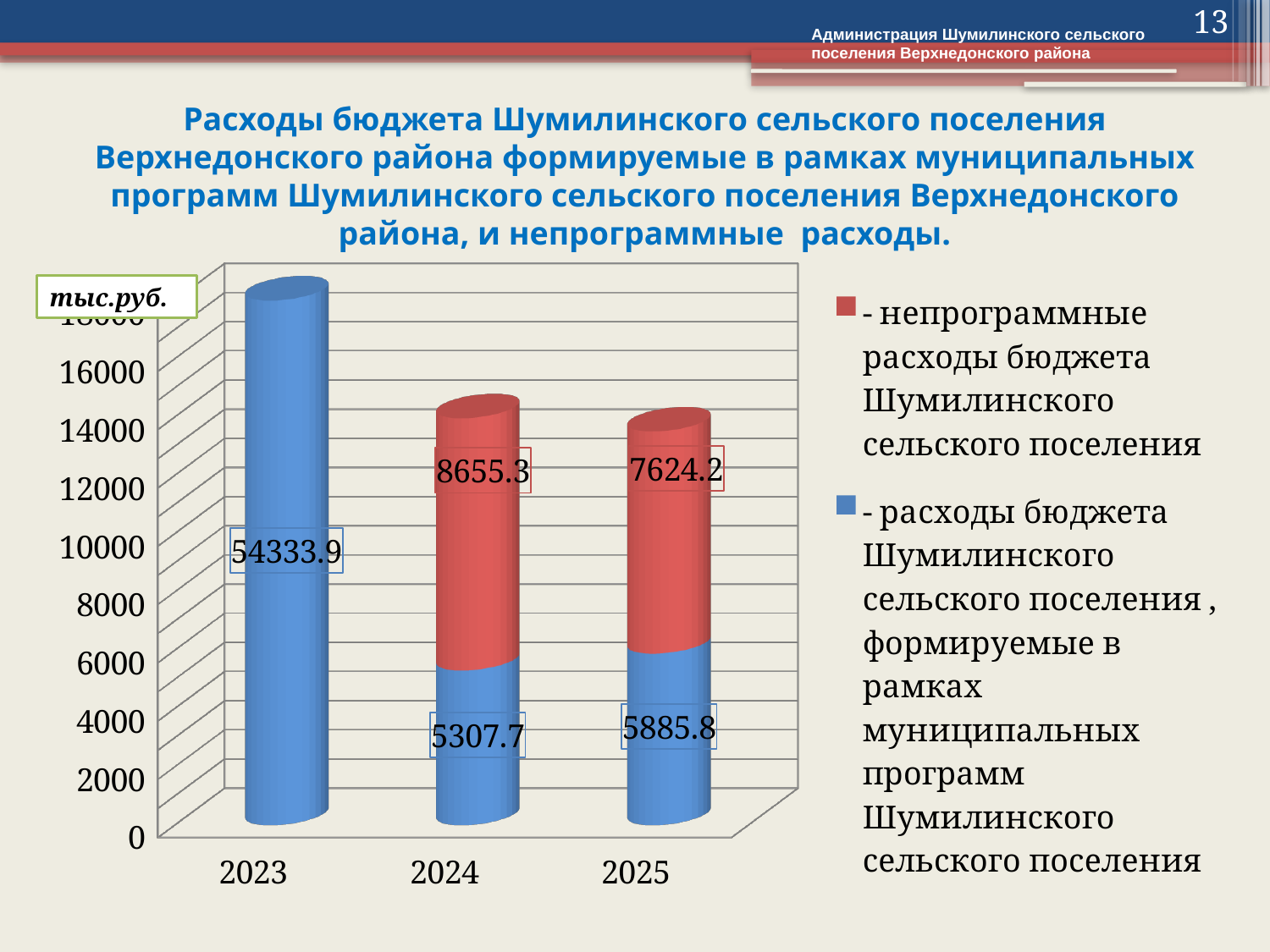
What is the value of the budget expenses formed within municipal programs (blue series) for 2024? 5307.7 What kind of chart is shown on the slide? Bar chart How many years are shown on the x axis of the chart? 3 How many series does the legend list? 2 What is the total of the stacked bar for 2024? 13963.0 By how much do non-program expenses in 2024 exceed those in 2025? 1031.1 What is the value of non-program budget expenses (red series) for 2024? 8655.3 Which year has the highest value for expenses formed within municipal programs (blue series)? 2023 In 2024, which is larger: non-program expenses or expenses within municipal programs? Non-program expenses What is the value of non-program budget expenses (red series) for 2025? 7624.2 What is the value of the budget expenses formed within municipal programs (blue series) for 2023? 54333.9 What is the total of the stacked bar for 2025? 13510.0